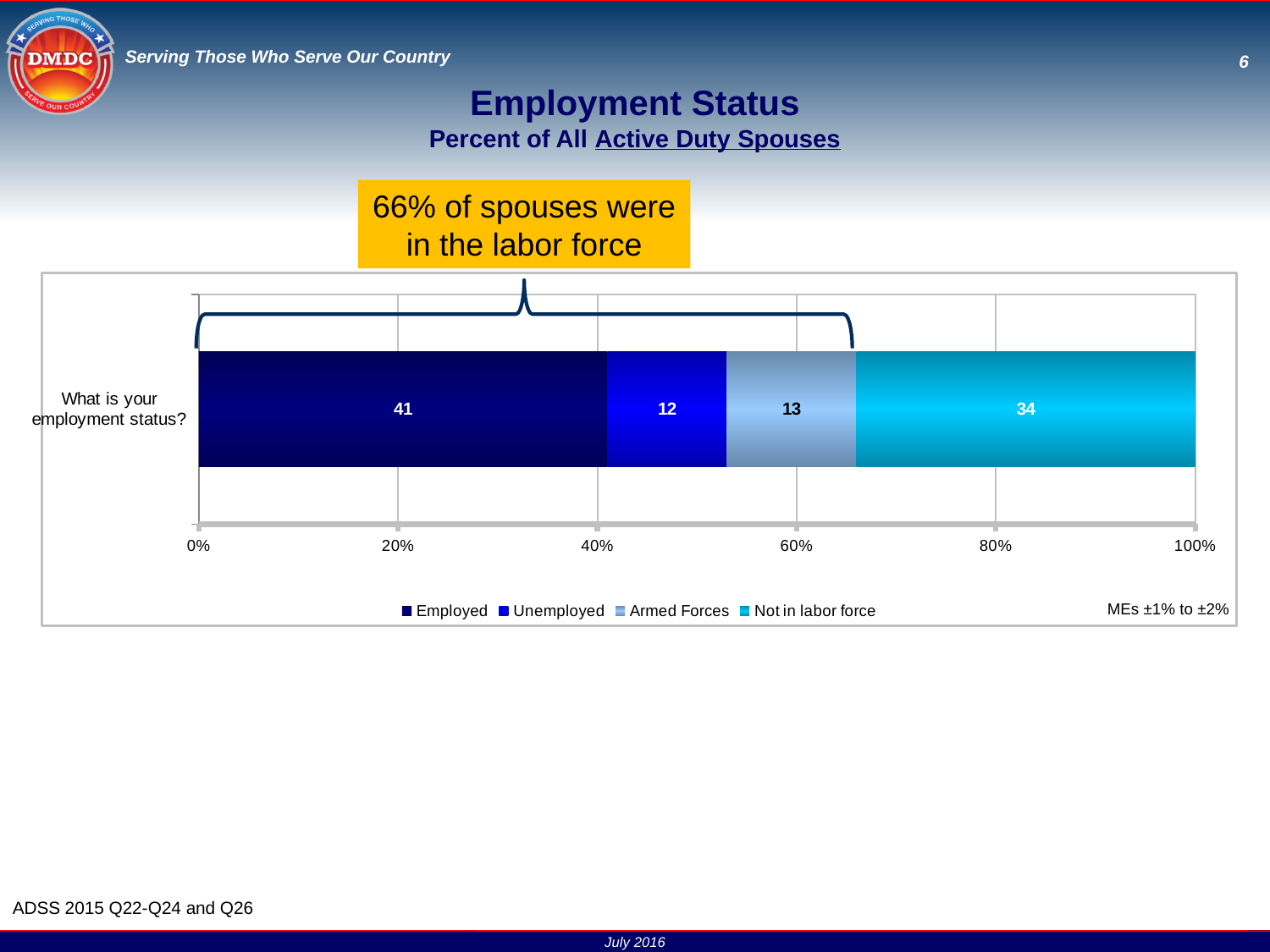
What is the total of the stacked bar for 'What is your employment status?'? 100 Which series has the lowest value in the employment status chart? Unemployed What is the value for Unemployed in the employment status chart? 12 What is the value for Employed in the employment status chart? 41 Which is larger, the value for Armed Forces or the value for Unemployed? Armed Forces How many series does the legend list? 4 What is the title of the chart on the slide? Employment Status What is the value for Armed Forces in the employment status chart? 13 What kind of chart is shown on the slide? Stacked bar chart What is the value for Not in labor force in the employment status chart? 34 Which series has the highest value in the employment status chart? Employed What is the difference between the Employed and Not in labor force values? 7